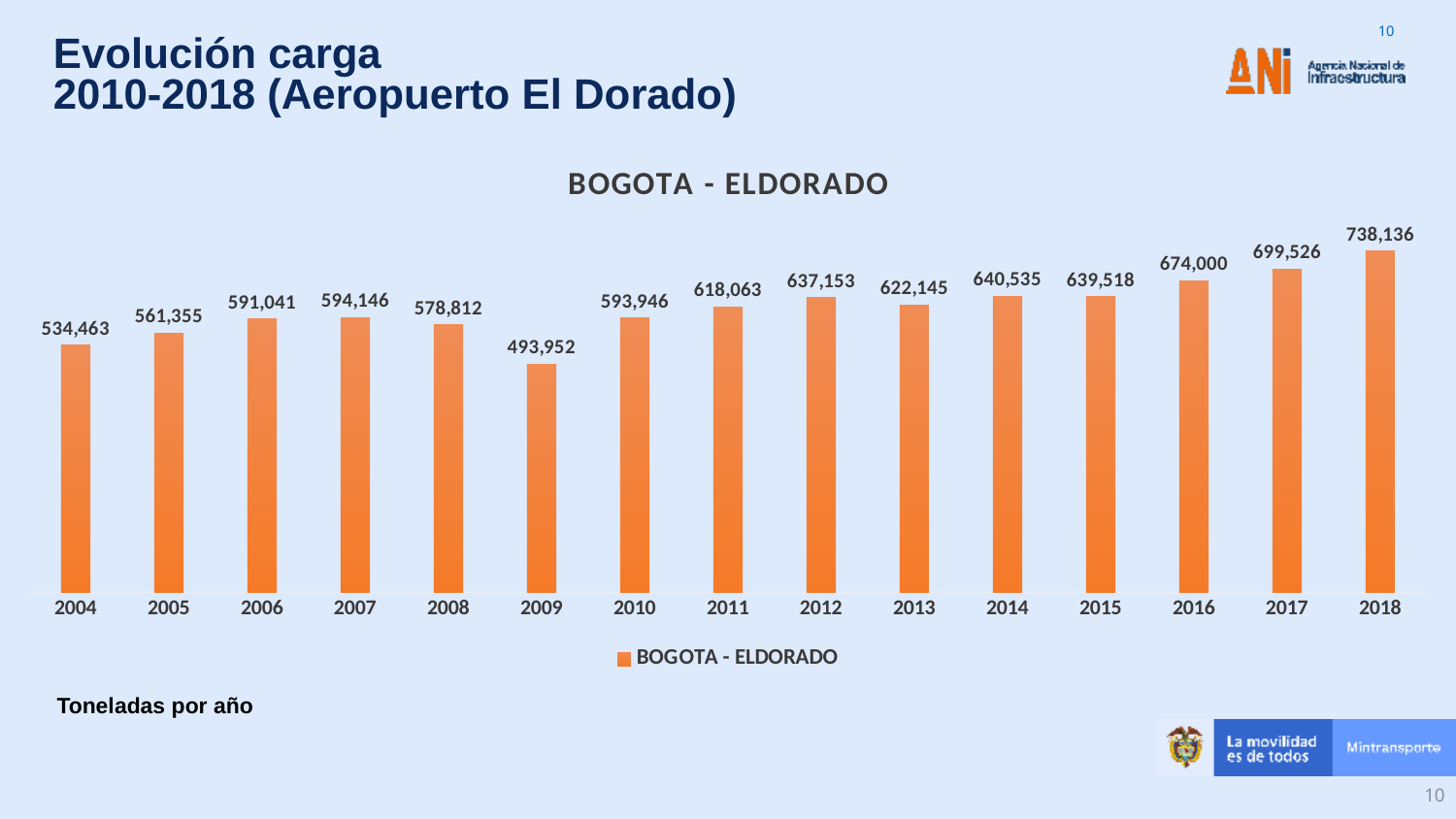
How many series does the legend of the BOGOTA - ELDORADO chart list? 1 Which year has the highest value in the BOGOTA - ELDORADO chart? 2018 What is the value for 2009 in the BOGOTA - ELDORADO chart? 493,952 What is the value for 2018 in the BOGOTA - ELDORADO chart? 738,136 What is the difference between the 2010 and 2009 values in the BOGOTA - ELDORADO chart? 99,994 Do the values in the BOGOTA - ELDORADO chart rise or fall from 2014 to 2018? Rise What is the difference between the 2018 and 2004 values in the BOGOTA - ELDORADO chart? 203,673 Which year has the lowest value in the BOGOTA - ELDORADO chart? 2009 What is the value for 2012 in the BOGOTA - ELDORADO chart? 637,153 How many years are shown on the x axis of the BOGOTA - ELDORADO chart? 15 What type of chart is shown on the slide? Bar chart Which year has a larger value in the BOGOTA - ELDORADO chart, 2013 or 2014? 2014